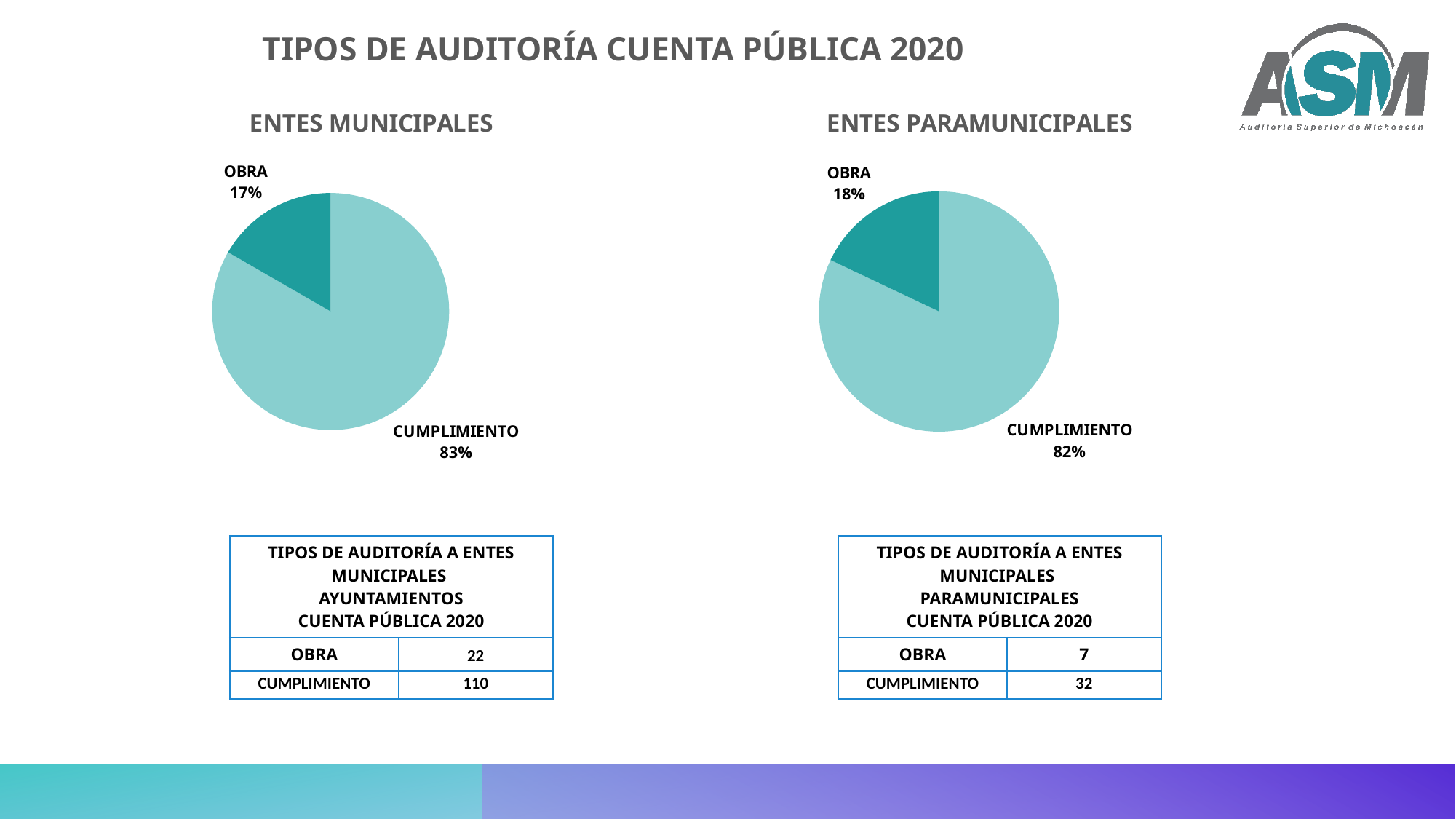
In the ENTES MUNICIPALES chart, what is the difference in percentage points between CUMPLIMIENTO and OBRA? 66 In the ENTES MUNICIPALES pie chart, what share does CUMPLIMIENTO have? 83% In the ENTES PARAMUNICIPALES chart, is the OBRA slice shown in a darker or lighter teal than the CUMPLIMIENTO slice? Darker What kind of chart is used for ENTES MUNICIPALES? Pie chart In the ENTES PARAMUNICIPALES pie chart, what share does CUMPLIMIENTO have? 82% In the ENTES PARAMUNICIPALES chart, which category has the smallest slice? OBRA In the ENTES PARAMUNICIPALES pie chart, what share does OBRA have? 18% What is the title of the pie chart on the left side of the slide? ENTES MUNICIPALES In the ENTES MUNICIPALES chart, which category has the largest slice? CUMPLIMIENTO How many slices does the ENTES PARAMUNICIPALES pie chart have? 2 Which is larger: the OBRA share in the ENTES MUNICIPALES chart or the OBRA share in the ENTES PARAMUNICIPALES chart? ENTES PARAMUNICIPALES